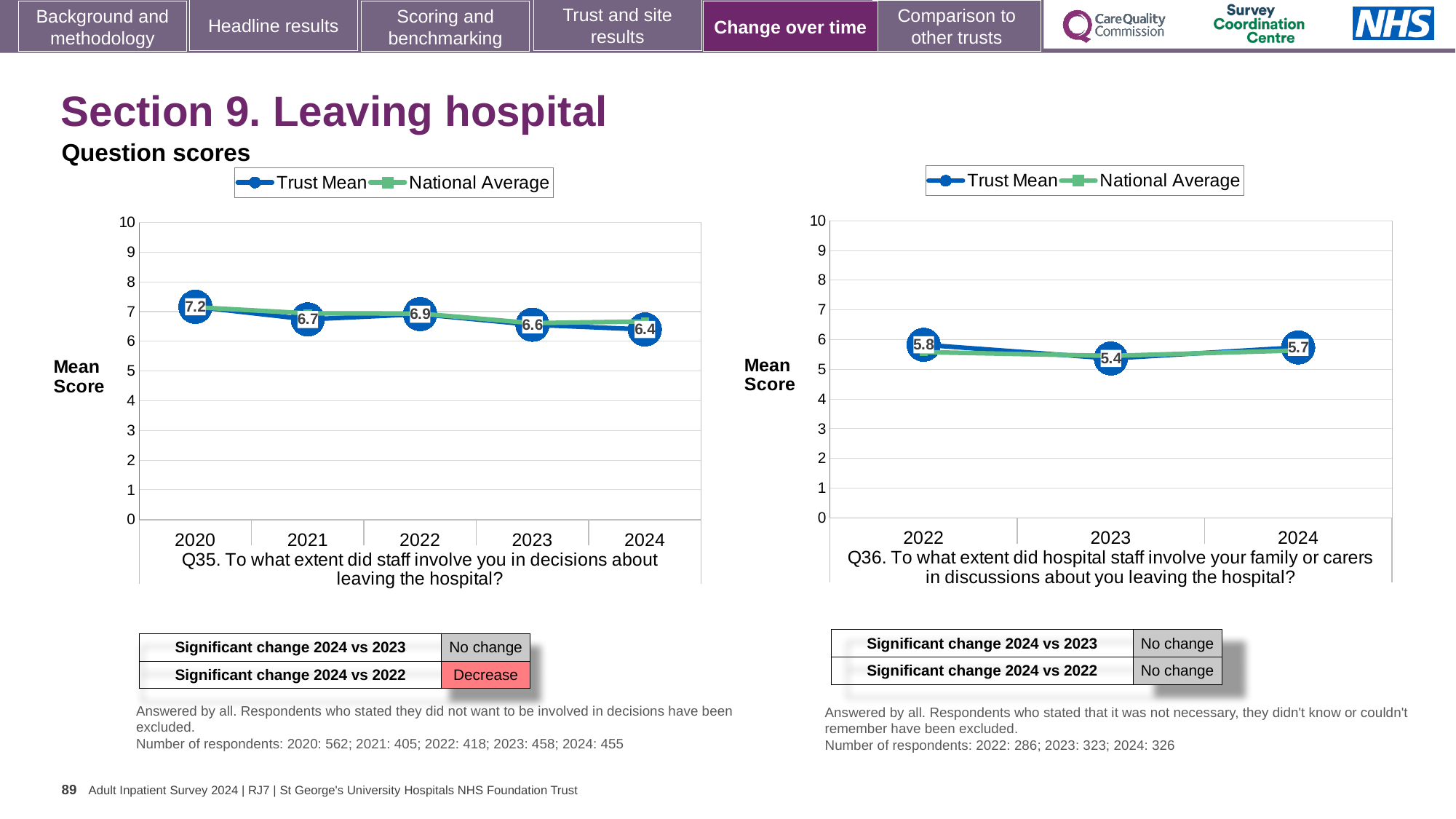
In the Q35 chart, how many years are plotted on the x axis? 5 In the Q36 chart, which year has the lowest Trust Mean score? 2023 In the Q36 chart, what is the Trust Mean score for 2023? 5.4 In the Q36 chart, which is larger, the Trust Mean score for 2022 or for 2023? 2022 In the Q35 chart, what is the Trust Mean score for 2020? 7.2 What type of chart is the Q35 chart? Line chart In the Q35 chart, which year has the highest Trust Mean score? 2020 How many series does the legend of the Q36 chart list? 2 In the Q35 chart, what is the difference between the Trust Mean scores for 2020 and 2024? 0.8 In the Q36 chart, is the Trust Mean score for 2022 greater or less than 6? less In the Q35 chart, what is the Trust Mean score for 2024? 6.4 In the Q35 chart, which year has the lowest Trust Mean score? 2024